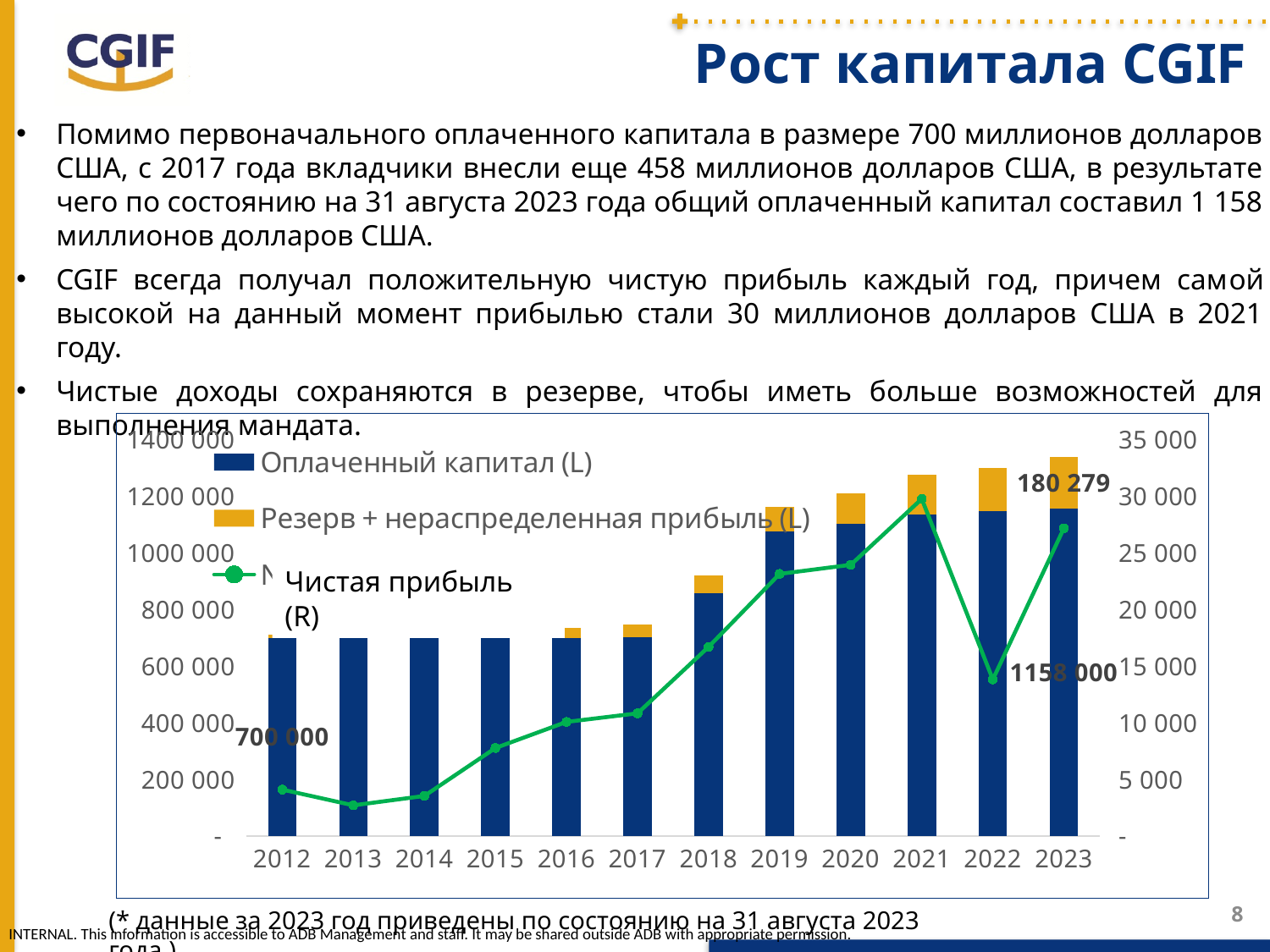
Does the Оплаченный капитал (L) series rise or fall from 2012 to 2023? rise How many years are shown on the x axis of the chart? 12 How many series does the chart legend list? 3 What is the value of Оплаченный капитал (L) for 2012 according to the data label? 700 000 Is the value of Оплаченный капитал (L) for 2019 greater or less than 1 000 000? greater Which axis, left or right, is used for the Чистая прибыль series? Right Does the Чистая прибыль (R) line rise or fall from 2021 to 2022? fall In which year does the Чистая прибыль (R) line reach its lowest point? 2013 What kind of chart is shown on the slide? A combination bar and line chart Is the value of Чистая прибыль (R) for 2021 greater or less than 25 000? greater In which year does the Чистая прибыль (R) line reach its highest point? 2021 Which year has the larger Чистая прибыль (R) value, 2018 or 2020? 2020